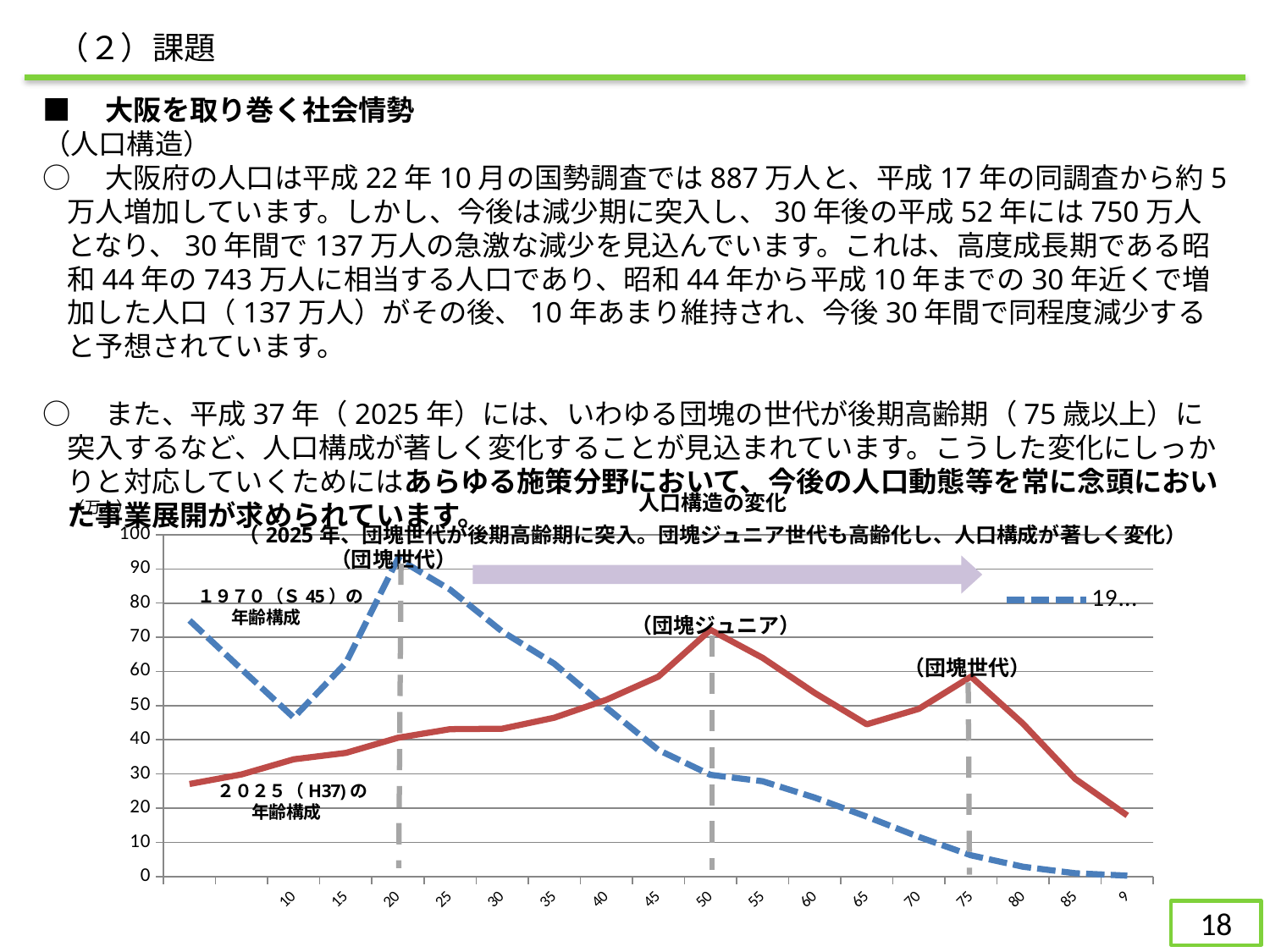
Is the value of the 2025 (H37) series at age 75 greater or less than 50? greater Is the value of the 1970 (S45) series at age 20 greater or less than 80? greater At age 75, which series has the higher value, 1970 (S45) or 2025 (H37)? 2025 (H37) At which age does the 2025 (H37) series reach its highest value? 50 At age 20, which series has the higher value, 1970 (S45) or 2025 (H37)? 1970 (S45) How many lines (series) are plotted in the chart? 2 What is the title of the chart? 人口構造の変化 What kind of chart is shown on the slide? line chart Is the value of the 1970 (S45) series at age 50 greater or less than 40? less Does the 1970 (S45) series rise or fall from age 20 to age 90? fall